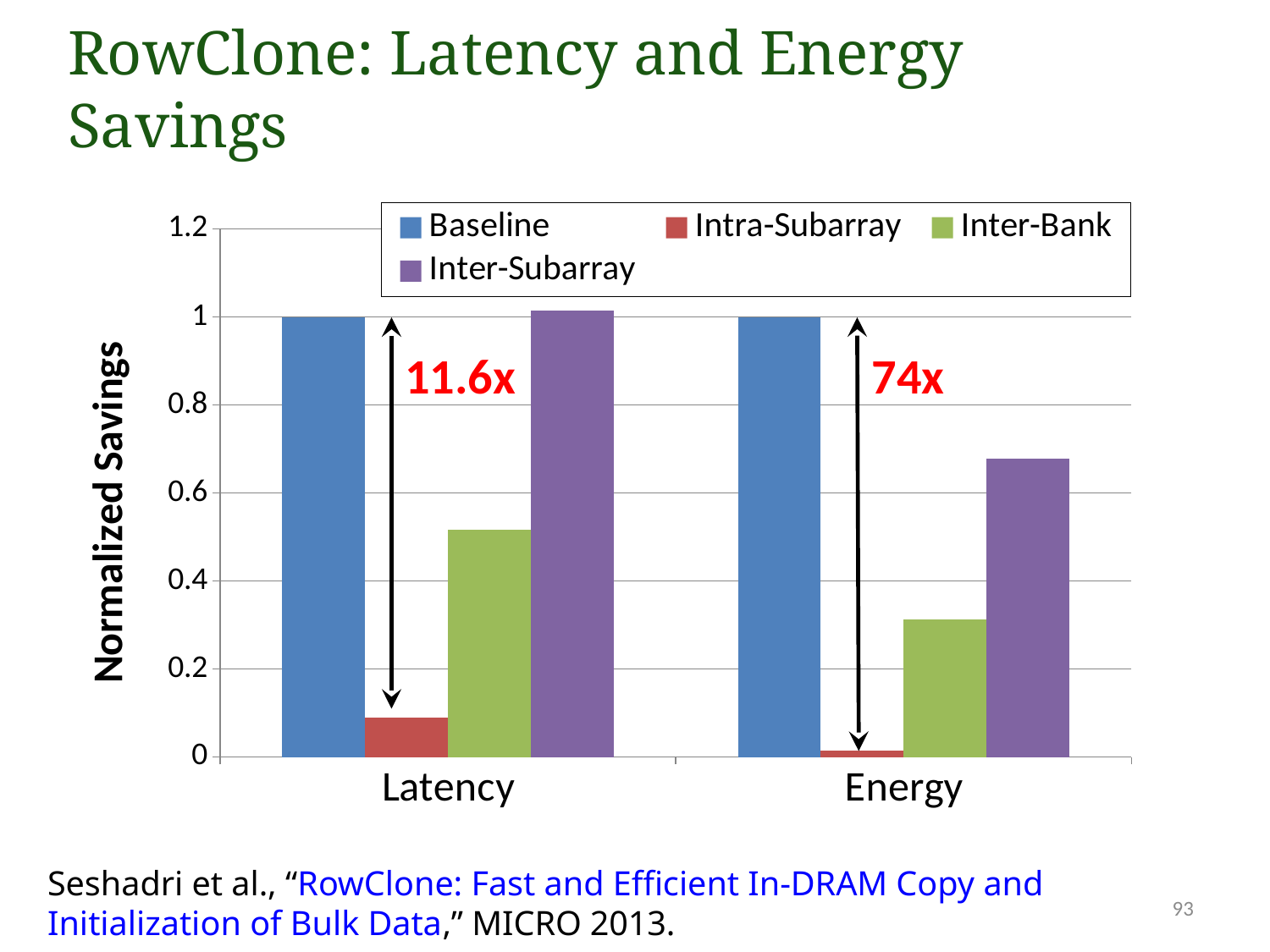
Which series has the lowest value in the Energy category? Intra-Subarray What is the Baseline value for Latency? 1 Is the Inter-Bank value for Energy greater or less than 0.4? less Which series has the lowest value in the Latency category? Intra-Subarray How many series does the legend list? 4 What is the Baseline value for Energy? 1 Is the Inter-Bank value for Latency greater or less than 0.4? greater How many categories are shown on the x axis? 2 Is the Inter-Subarray value for Energy greater or less than 0.6? greater Which is larger: the Inter-Subarray value for Latency or the Inter-Subarray value for Energy? Latency Which series has the highest value in the Energy category? Baseline What kind of chart is shown on the slide? bar chart